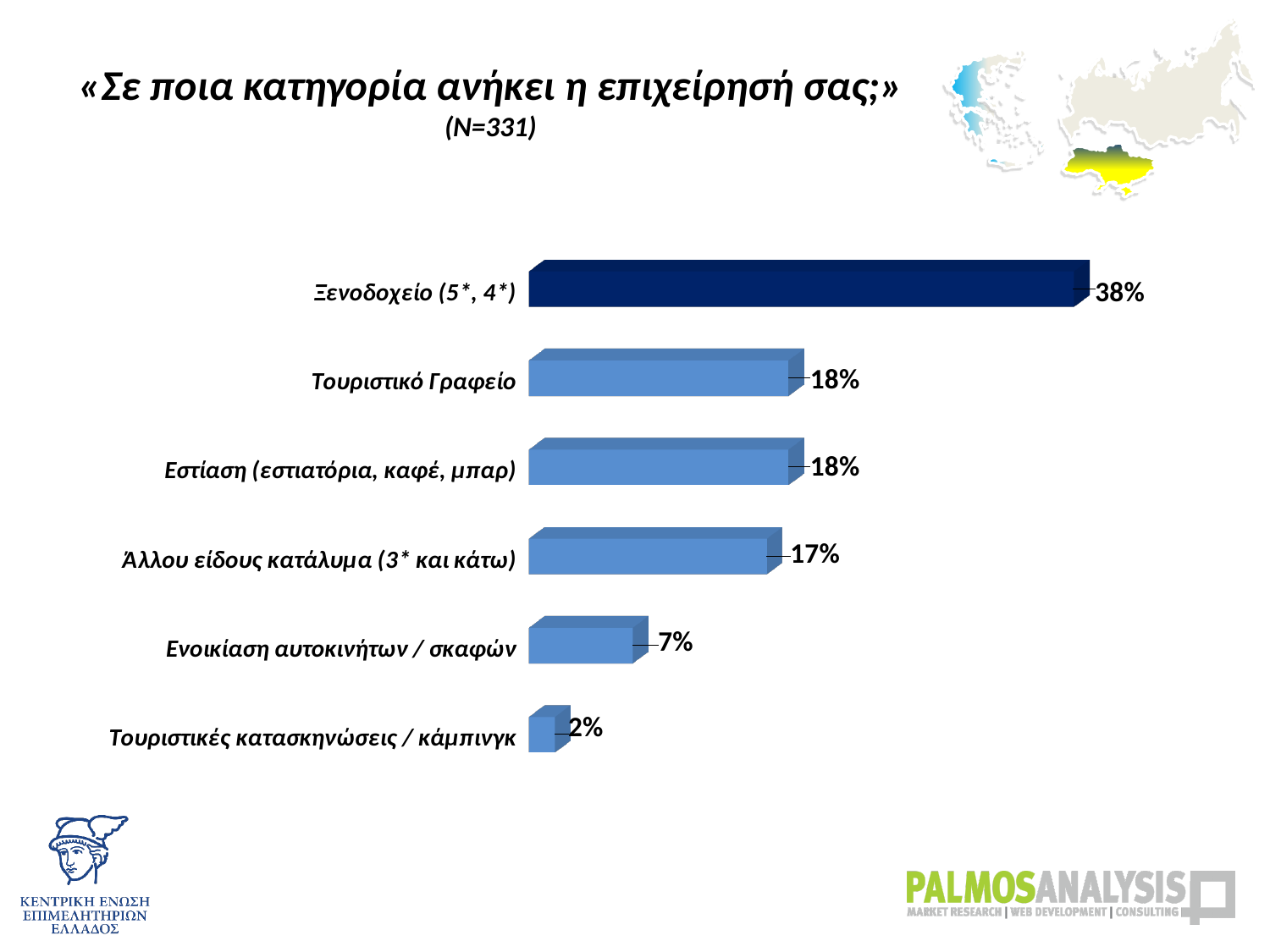
Which category has the lowest value? Τουριστικές κατασκηνώσεις / κάμπινγκ What is the difference between the values for Άλλου είδους κατάλυμα (3* και κάτω) and Ενοικίαση αυτοκινήτων / σκαφών? 10% What is the difference between the values for Ξενοδοχείο (5*, 4*) and Τουριστικό Γραφείο? 20% How many categories are shown in the chart? 6 What is the value shown for Τουριστικές κατασκηνώσεις / κάμπινγκ? 2% Which category has the highest value? Ξενοδοχείο (5*, 4*) What kind of chart is shown on the slide? Bar chart What is the value shown for Ενοικίαση αυτοκινήτων / σκαφών? 7% Which is larger, the value for Εστίαση (εστιατόρια, καφέ, μπαρ) or the value for Άλλου είδους κατάλυμα (3* και κάτω)? Εστίαση (εστιατόρια, καφέ, μπαρ) What percentage of businesses are in the category Ξενοδοχείο (5*, 4*)? 38% What is the sample size (N) stated under the chart title? N=331 What is the value shown for Τουριστικό Γραφείο? 18%